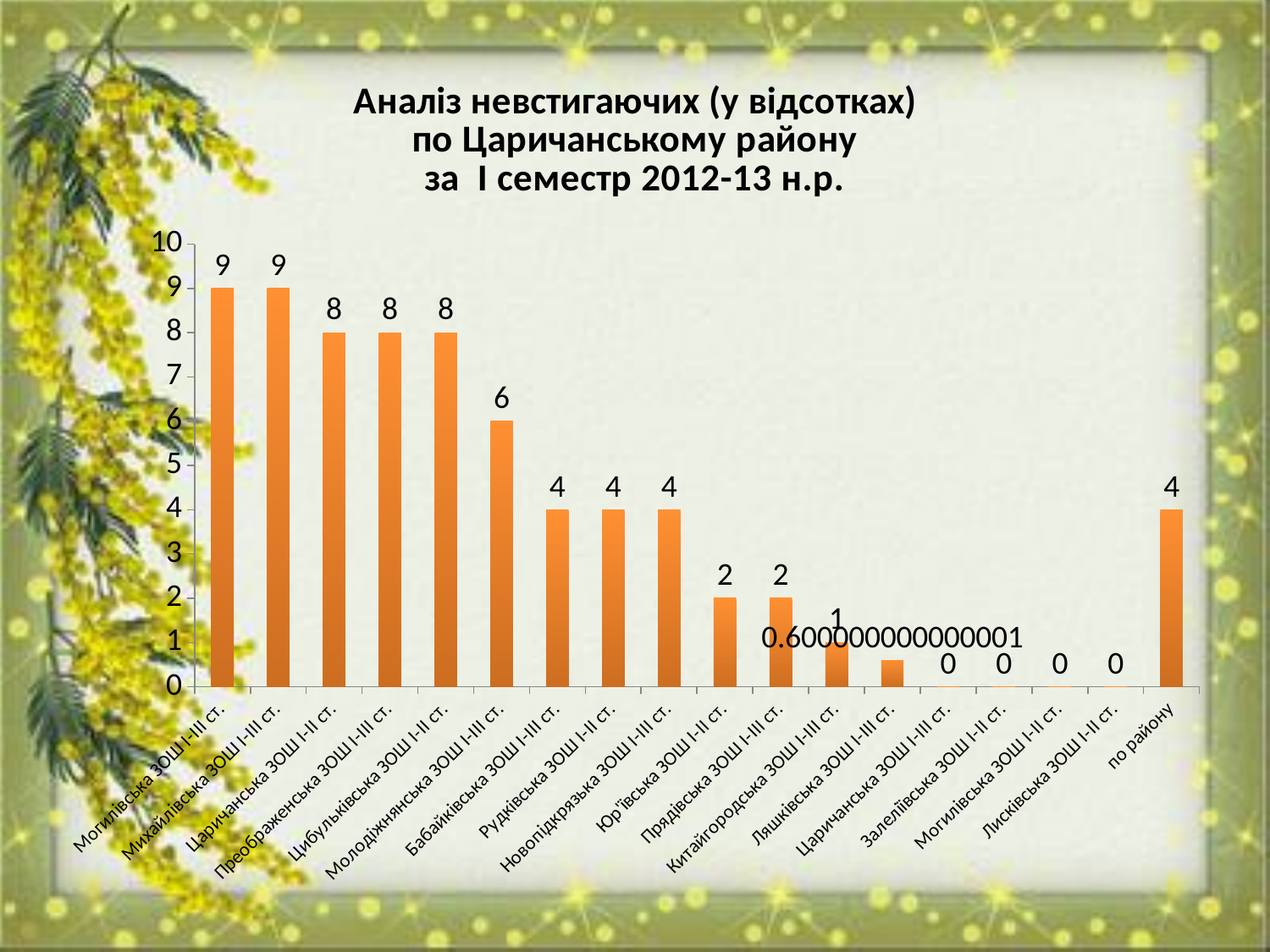
What is the value shown for "по району"? 4 Is the value for Рудківська ЗОШ І-ІІ ст. greater or less than 5? less How many categories are shown on the x axis? 18 What is the difference between the values for Михайлівська ЗОШ І-ІІІ ст. and Юр'ївська ЗОШ І-ІІ ст.? 7 What is the difference between the values for Молодіжнянська ЗОШ І-ІІІ ст. and Прядівська ЗОШ І-ІІІ ст.? 4 What kind of chart is shown on the slide? bar chart What is the value for Китайгородська ЗОШ І-ІІІ ст.? 1 What is the value for Молодіжнянська ЗОШ І-ІІІ ст.? 6 Do the values for the schools generally rise or fall from left to right across the chart (before the final "по району" bar)? fall Which has a larger value, Преображенська ЗОШ І-ІІІ ст. or Бабайківська ЗОШ І-ІІІ ст.? Преображенська ЗОШ І-ІІІ ст. What is the value for Цибульківська ЗОШ І-ІІ ст.? 8 What data label is shown for Ляшківська ЗОШ І-ІІІ ст.? 0.600000000000001